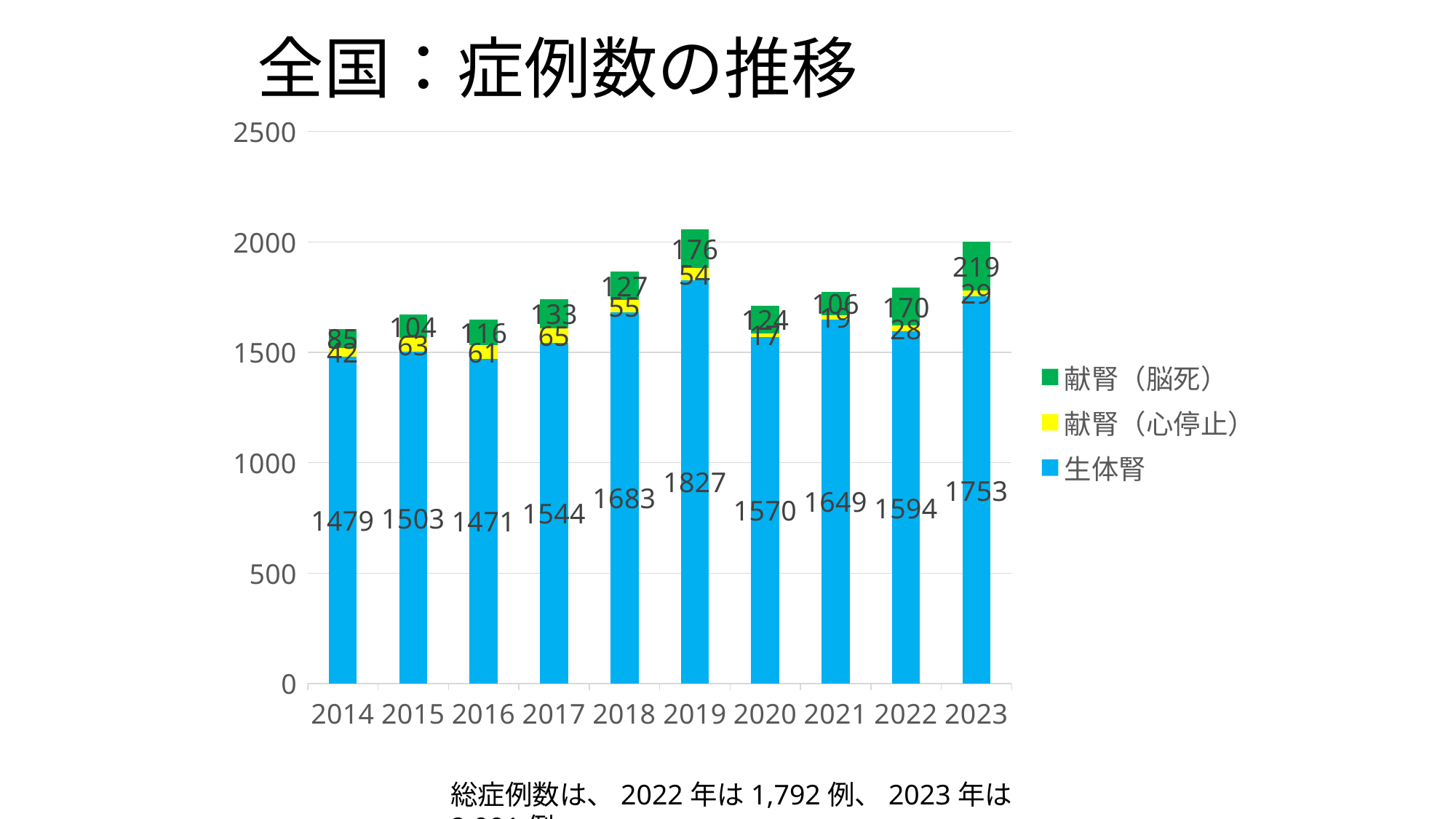
What is the total of the stacked bar for 2022? 1792 What is the value of 献腎（心停止） for 2020? 17 Which year has the larger 献腎（脳死） value, 2019 or 2023? 2023 What is the difference between the 生体腎 values for 2023 and 2022? 159 What is the value of 献腎（脳死） for 2023? 219 Which year has the lowest value for 生体腎? 2016 How many years are shown on the x axis? 10 What is the value of 生体腎 for 2019? 1827 Which year has the highest value for 生体腎? 2019 Is the total of the stacked bar for 2019 greater or less than 2000? greater What kind of chart is shown on the slide? stacked bar chart How many series does the legend list? 3